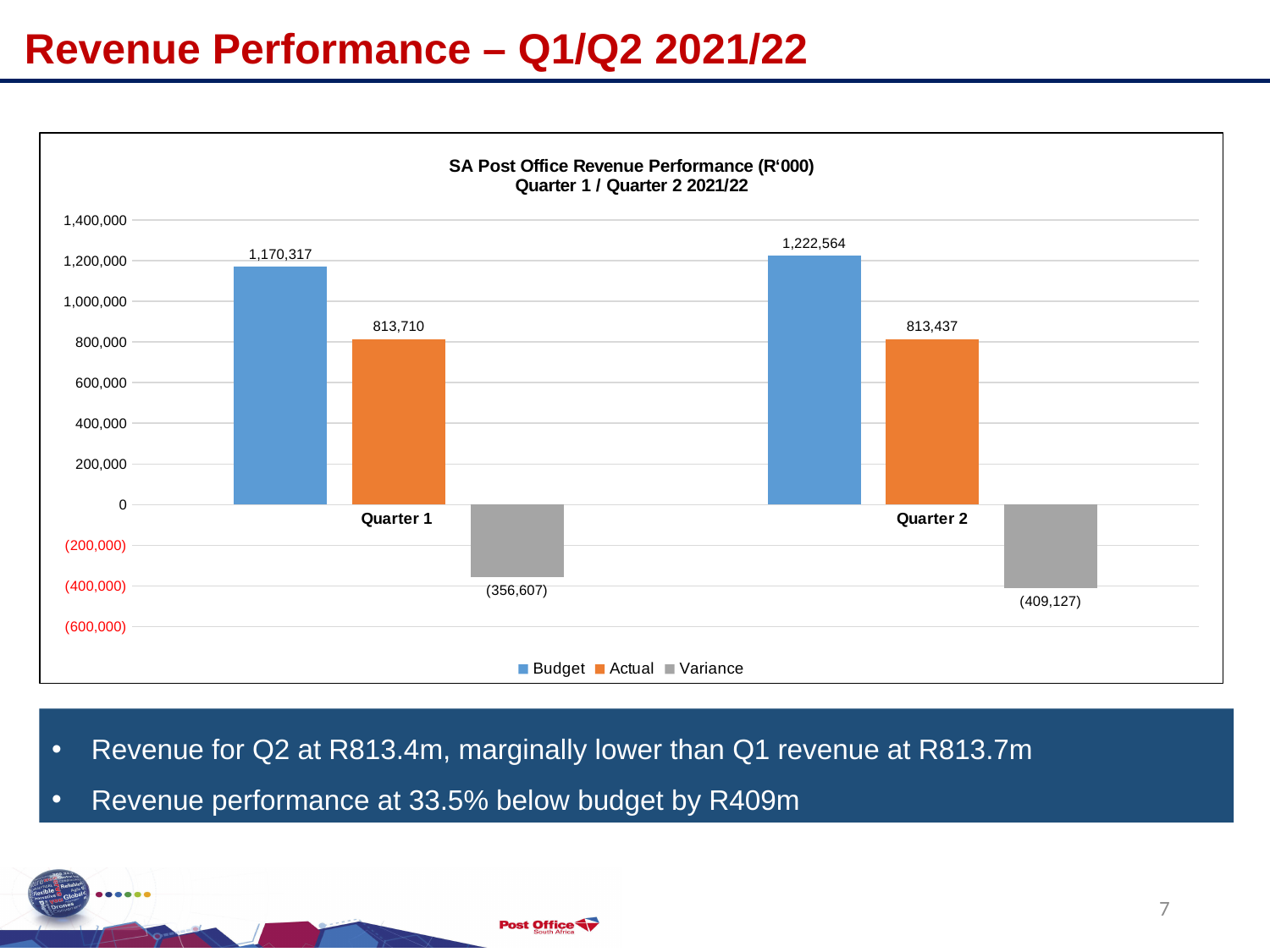
What kind of chart is shown on the slide? Bar chart What is the Budget value for Quarter 2? 1,222,564 How many quarters are shown on the x axis? 2 Which series is shown in grey in the legend? Variance What is the Variance value for Quarter 1? (356,607) How many series does the legend list? 3 Which quarter has the higher Budget value? Quarter 2 What is the title of the chart? SA Post Office Revenue Performance (R'000) Quarter 1 / Quarter 2 2021/22 What is the Actual value for Quarter 2? 813,437 What is the difference between the Budget values for Quarter 2 and Quarter 1? 52,247 What is the difference between the Budget and Actual values for Quarter 1? 356,607 What is the Budget value for Quarter 1? 1,170,317